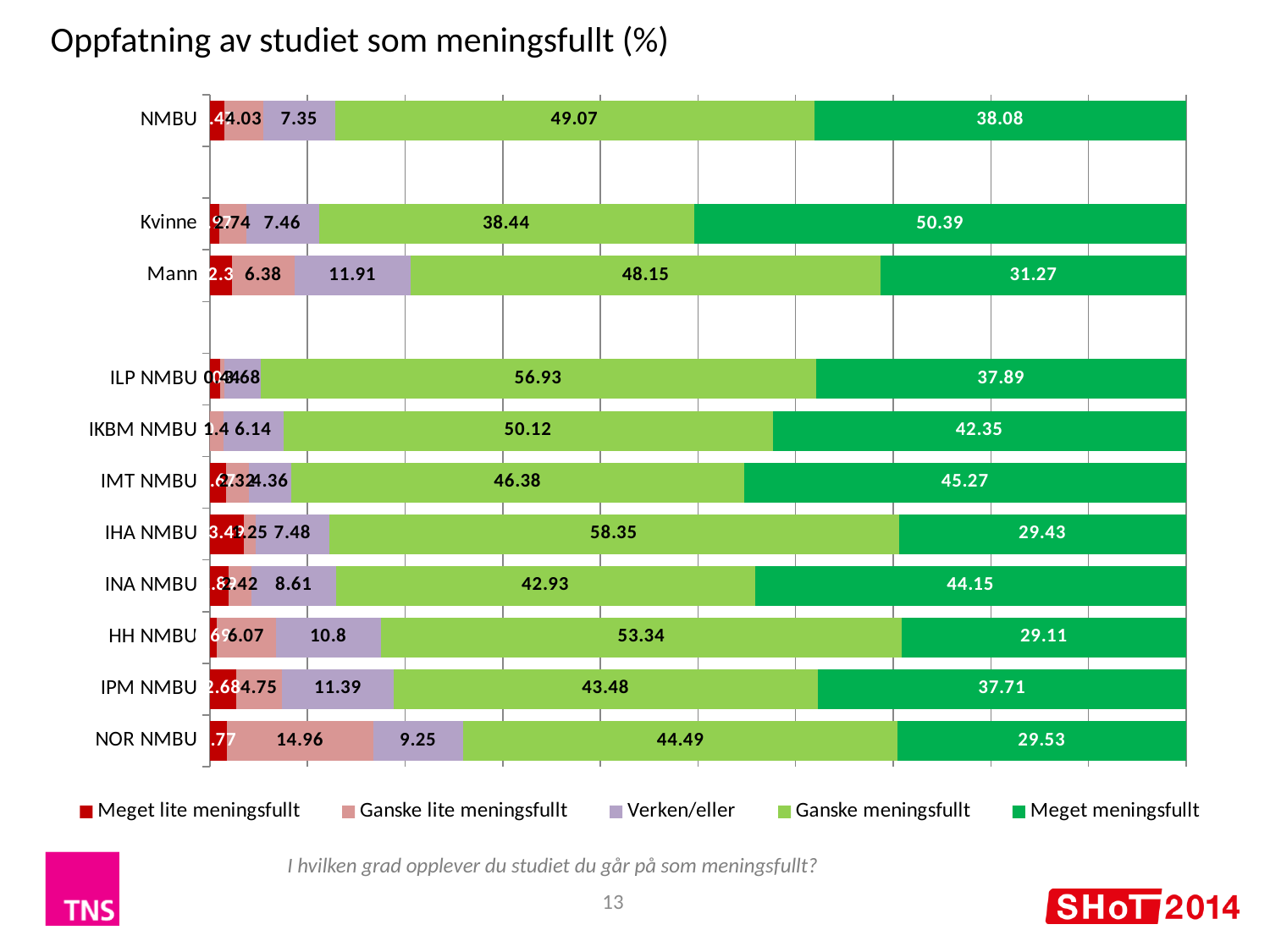
What is the value for "Meget meningsfullt" for Kvinne? 50.39 Which category has the lowest value for "Meget meningsfullt"? HH NMBU How many categories are plotted on the chart? 11 What is the difference between the "Meget meningsfullt" values for Kvinne and Mann? 19.12 Which is larger for IPM NMBU: "Ganske meningsfullt" or "Meget meningsfullt"? Ganske meningsfullt What is the title of the chart? Oppfatning av studiet som meningsfullt (%) What kind of chart is shown on the slide? Stacked bar chart How many series does the legend list? 5 What is the value for "Ganske meningsfullt" for IHA NMBU? 58.35 Which category has the highest value for "Meget meningsfullt"? Kvinne What is the value for "Ganske lite meningsfullt" for NOR NMBU? 14.96 What is the value for "Verken/eller" for Mann? 11.91